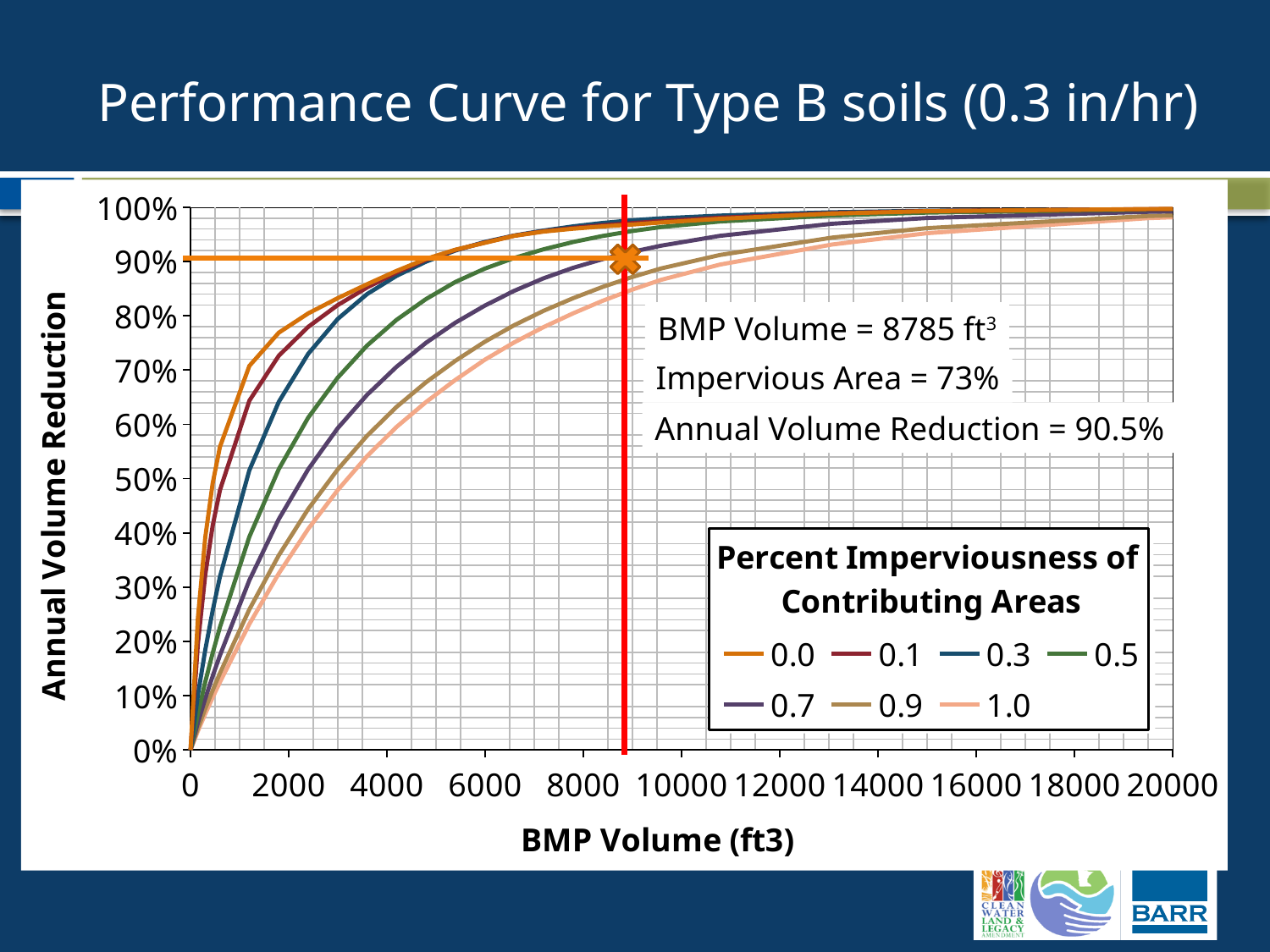
Which series has the lowest Annual Volume Reduction at a BMP Volume of 2000? 1.0 Do the curves rise or fall as BMP Volume increases along the x axis? rise What is the label of the y axis? Annual Volume Reduction What BMP Volume is marked by the annotation on the chart? 8785 ft3 How many series does the legend list? 7 At a BMP Volume of 4000, which series has the larger Annual Volume Reduction, 0.0 or 1.0? 0.0 What is the title of the legend? Percent Imperviousness of Contributing Areas Which series has the highest Annual Volume Reduction at a BMP Volume of 2000? 0.0 What Impervious Area is stated in the annotation on the chart? 73% What kind of chart is shown on the slide? line chart What Annual Volume Reduction is stated in the annotation on the chart? 90.5% Is the value for the 0.0 series at a BMP Volume of 2000 greater or less than 70%? greater